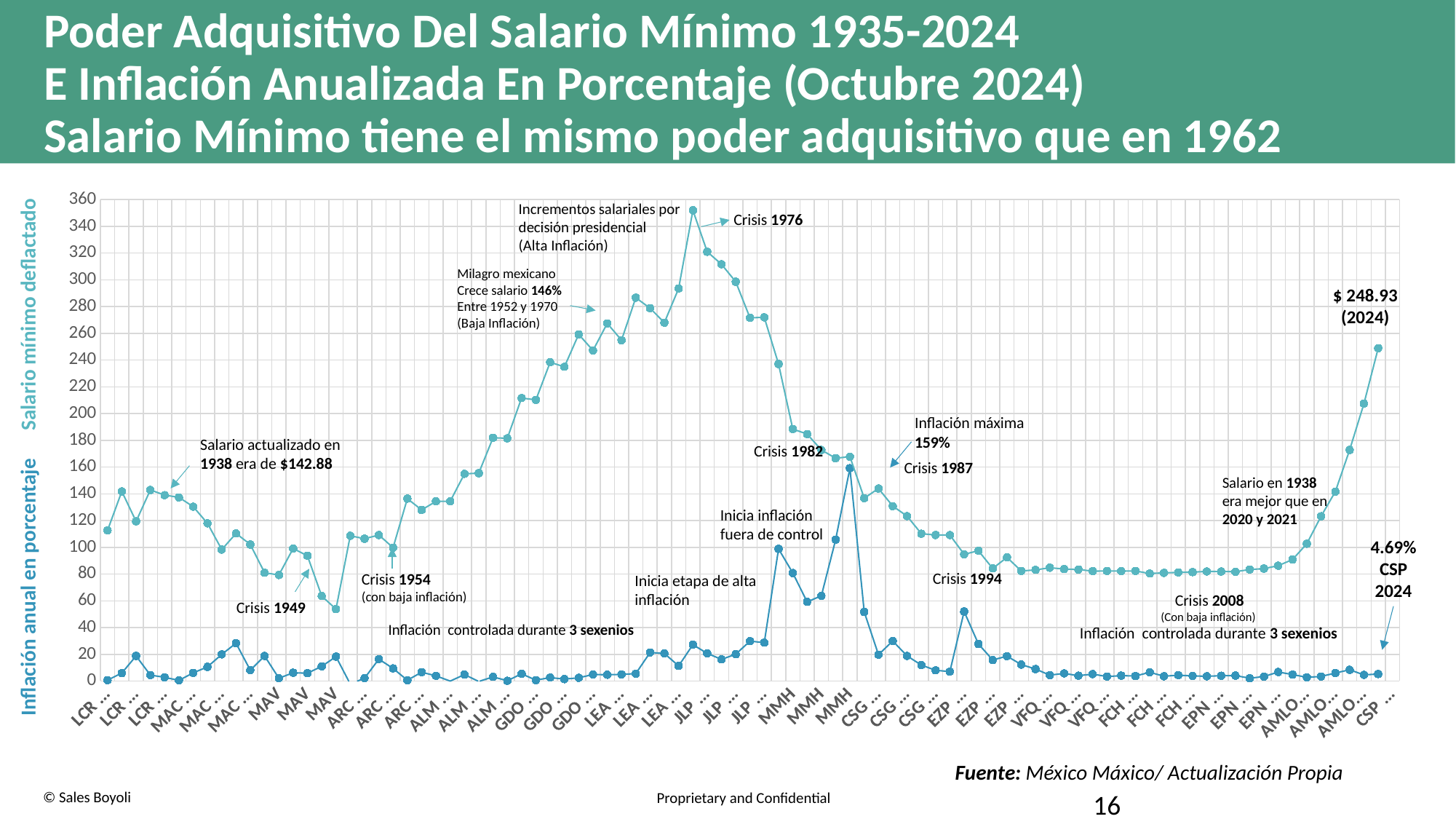
According to the annotation, what is the deflated minimum wage value for 2024? $ 248.93 What kind of chart is shown on the slide? line chart What is the difference between the deflated minimum wage in 2024 ($248.93) and in 1938 ($142.88)? $106.05 According to the annotation, what was the updated minimum wage in 1938? $142.88 How many data series are plotted on the chart? 2 Which crisis year is annotated at the peak of the deflated minimum wage series? 1976 Is the deflated minimum wage during the VFQ period greater or less than 100? less According to the slide title, the minimum wage has the same purchasing power as in which year? 1962 Is the peak value of the deflated minimum wage series greater or less than 340? greater What annual inflation percentage is annotated for CSP 2024? 4.69% From the AMLO period to the CSP period, does the deflated minimum wage rise or fall? rise Which is larger, the deflated minimum wage in 2024 or in 1938? 2024